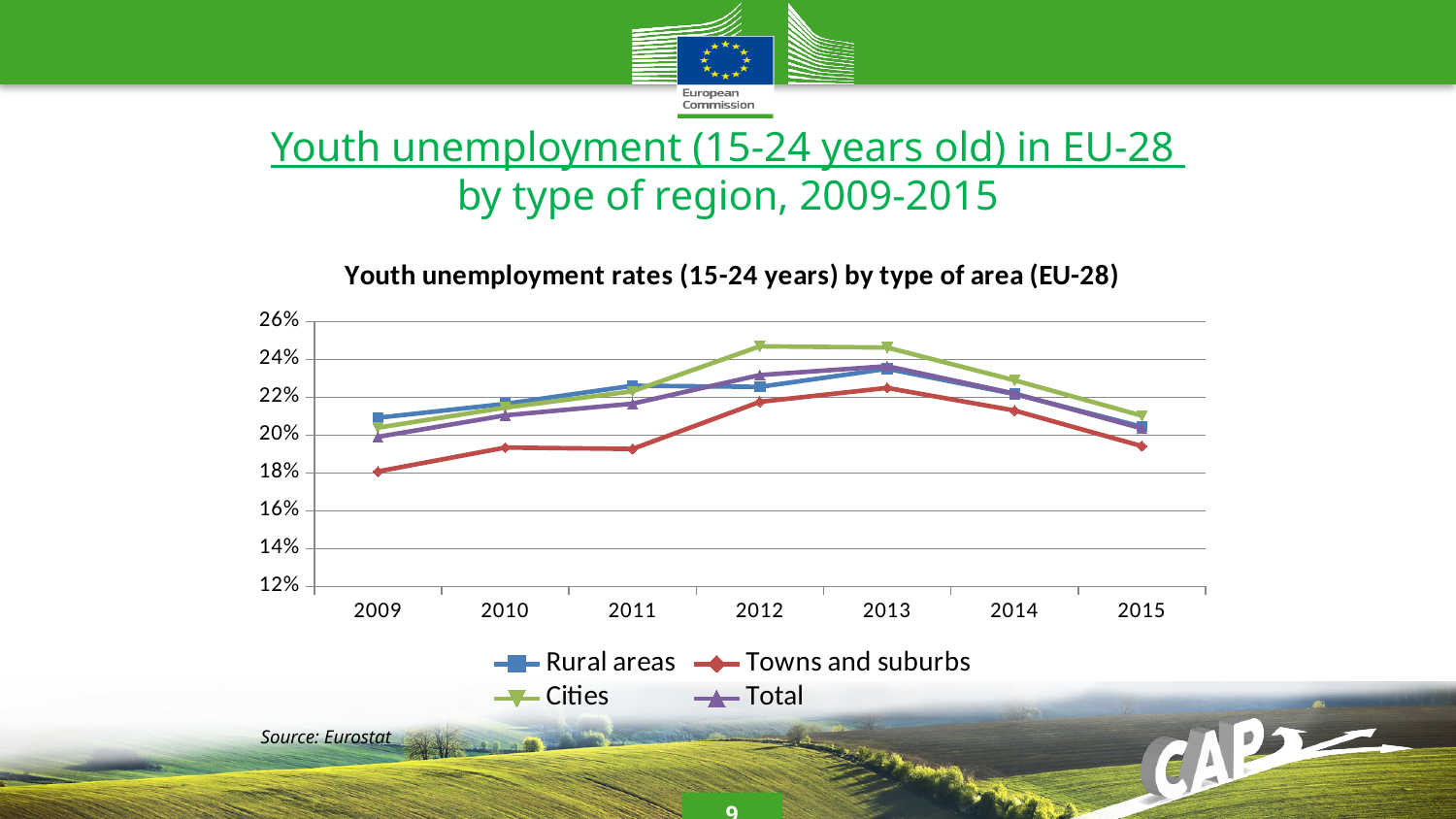
What kind of chart is shown on the slide? Line chart How many series does the legend list? 4 In which year does the Rural areas series reach its highest value? 2013 In 2009, which is higher: Rural areas or Towns and suburbs? Rural areas Does the Towns and suburbs series rise or fall from 2013 to 2015? Fall Is the value for Cities in 2012 greater or less than 24%? greater What is the title of the chart? Youth unemployment rates (15-24 years) by type of area (EU-28) Which series has the lowest value in 2009? Towns and suburbs Is the value for Rural areas in 2015 greater or less than 22%? less In 2013, which is higher: Cities or Towns and suburbs? Cities How many years are shown on the x axis? 7 Is the value for Towns and suburbs in 2009 greater or less than 20%? less